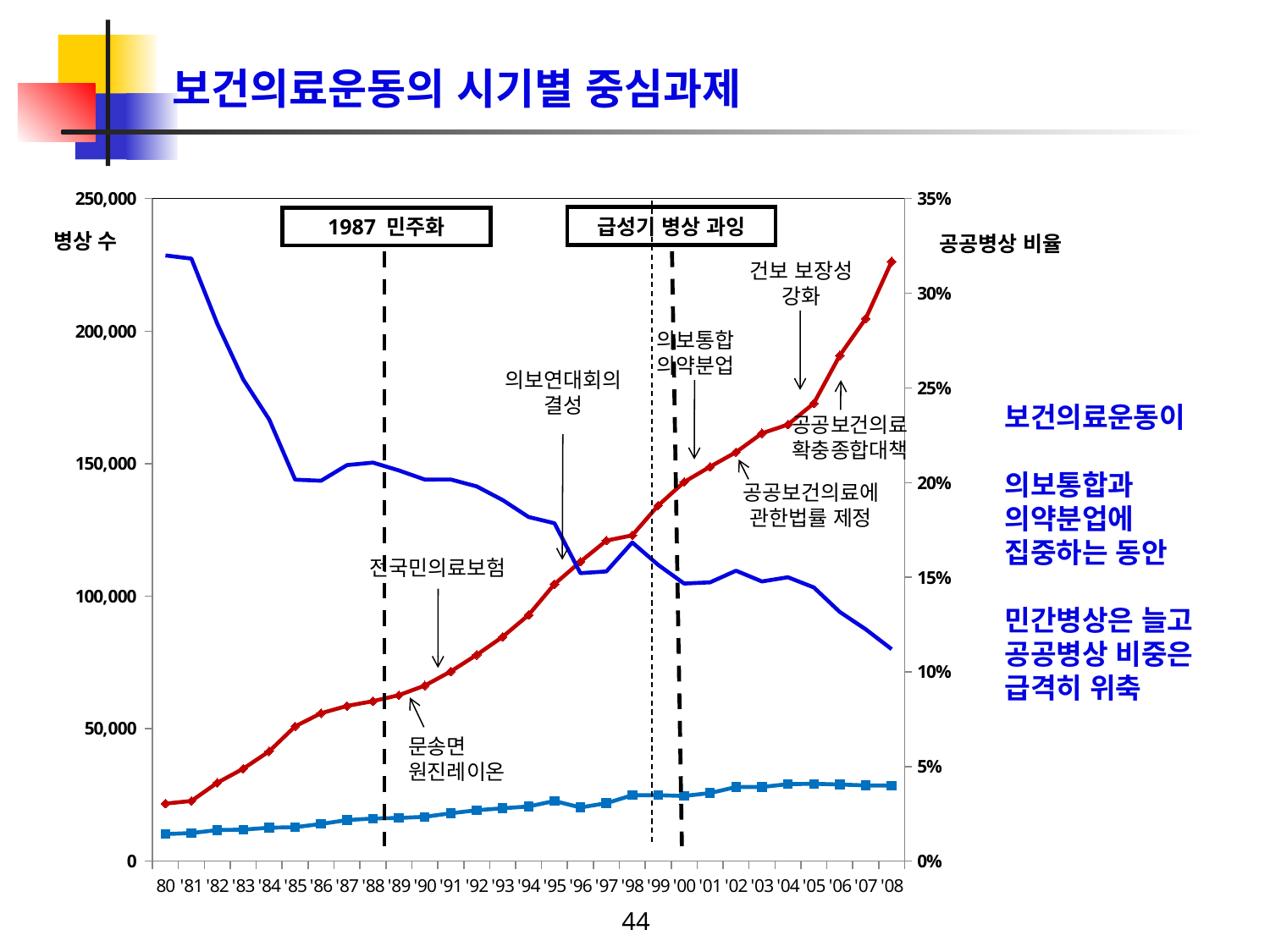
Does the red line with diamond markers rise or fall from '80 to '08? rise Is the value of the blue line without markers at '80 greater or less than 30% on the right axis? greater How many years are marked along the x axis of the chart? 29 What kind of chart is shown on the slide? line chart Is the value of the red line with diamond markers at '08 greater or less than 200,000 on the left axis? greater Is the value of the blue line without markers at '08 greater or less than 15% on the right axis? less What is the title of the right vertical axis? 공공병상 비율 What is the title of the left vertical axis? 병상 수 Does the blue line without markers rise or fall from '80 to '08? fall